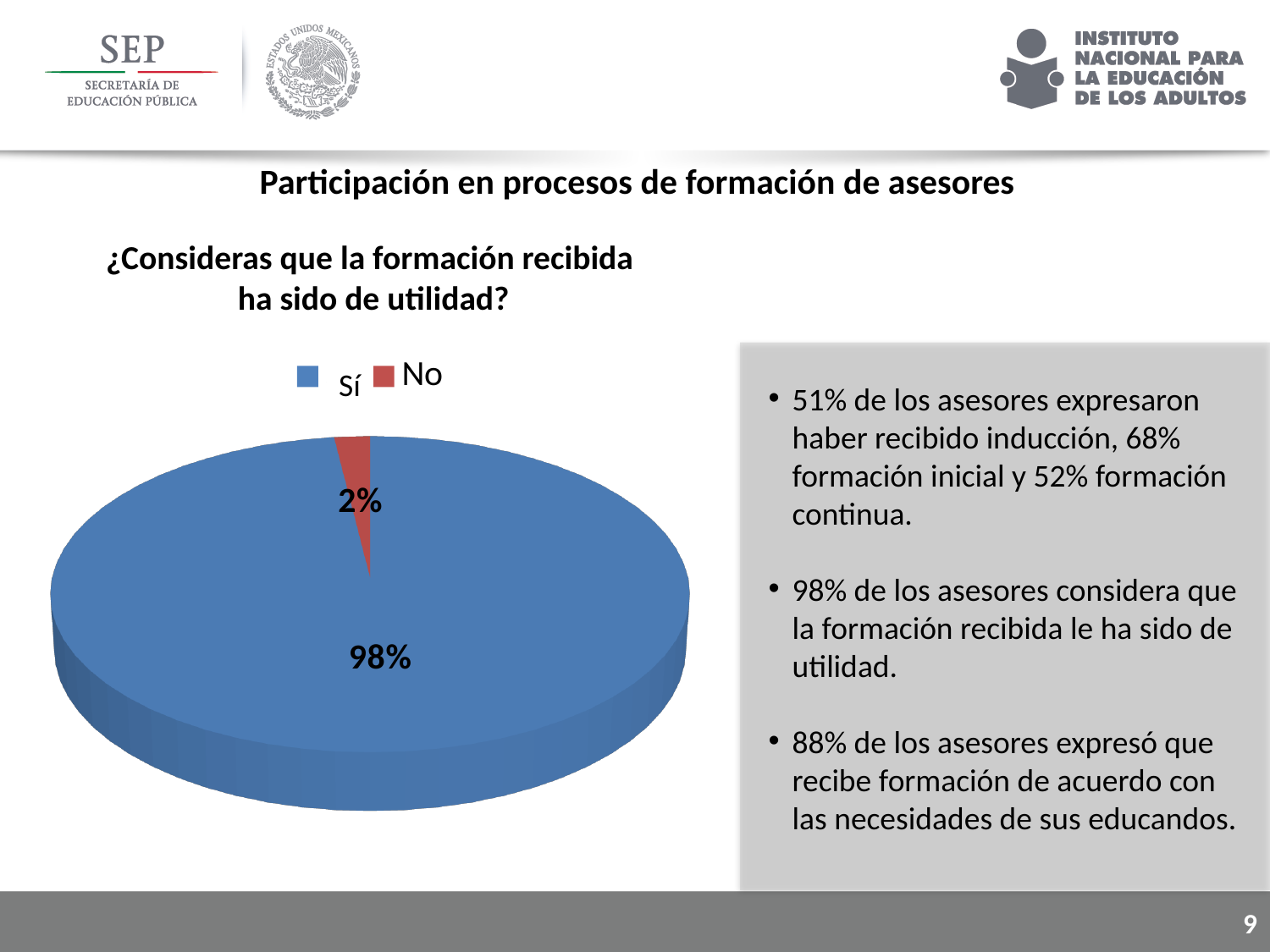
How many categories does the pie chart show? 2 What share of the pie does the "Sí" slice represent? 98% What is the difference in percentage points between the "Sí" and "No" slices? 96 Which category has the largest slice of the pie? Sí What percentage of the pie corresponds to "Sí"? 98% Which slice is larger, "Sí" or "No"? Sí How many entries does the legend list? 2 Which category has the smallest slice of the pie? No What kind of chart is shown on the slide? pie chart What percentage of the pie corresponds to "No"? 2% What colour is the "No" slice of the pie? red What question is the pie chart titled with? ¿Consideras que la formación recibida ha sido de utilidad?